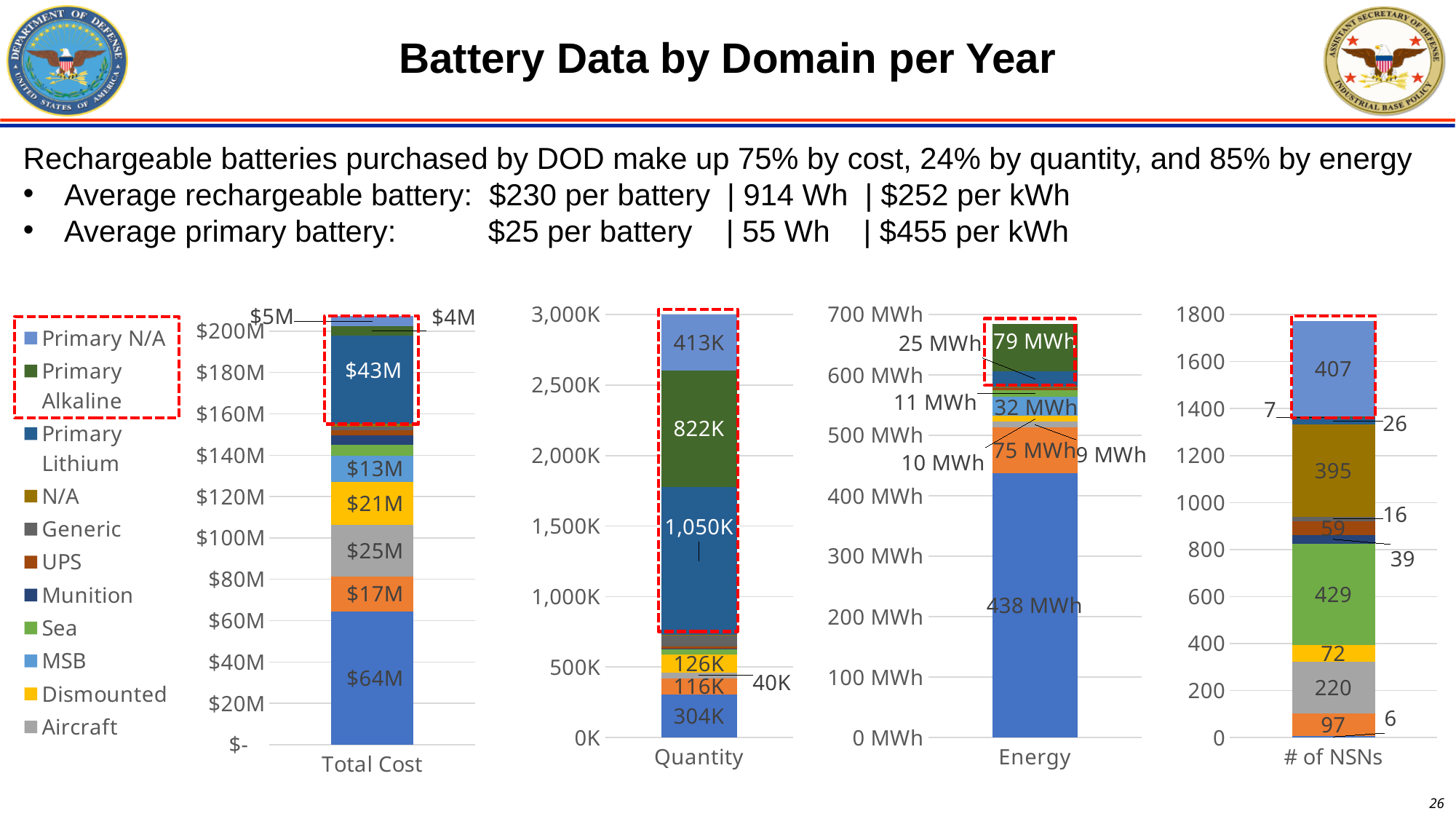
In the Quantity chart, what is the difference between Primary Lithium and Primary Alkaline? 228K How many charts are shown on the slide? 4 In the # of NSNs chart, what is the value for Sea? 429 In the # of NSNs chart, which is larger, Aircraft or Dismounted? Aircraft In the Total Cost chart, what is the value for Primary Lithium? $43M In the Quantity chart, what is the value for Primary Lithium? 1,050K In the Quantity chart, what is the value for Primary Alkaline? 822K In the Total Cost chart, what is the value for Aircraft? $25M In the Quantity chart, what is the value for Primary N/A? 413K In the Quantity chart, which segment is the largest? Primary Lithium In the Total Cost chart, is the total height of the bar greater or less than $200M? greater What kind of chart is the Total Cost chart? Stacked bar chart